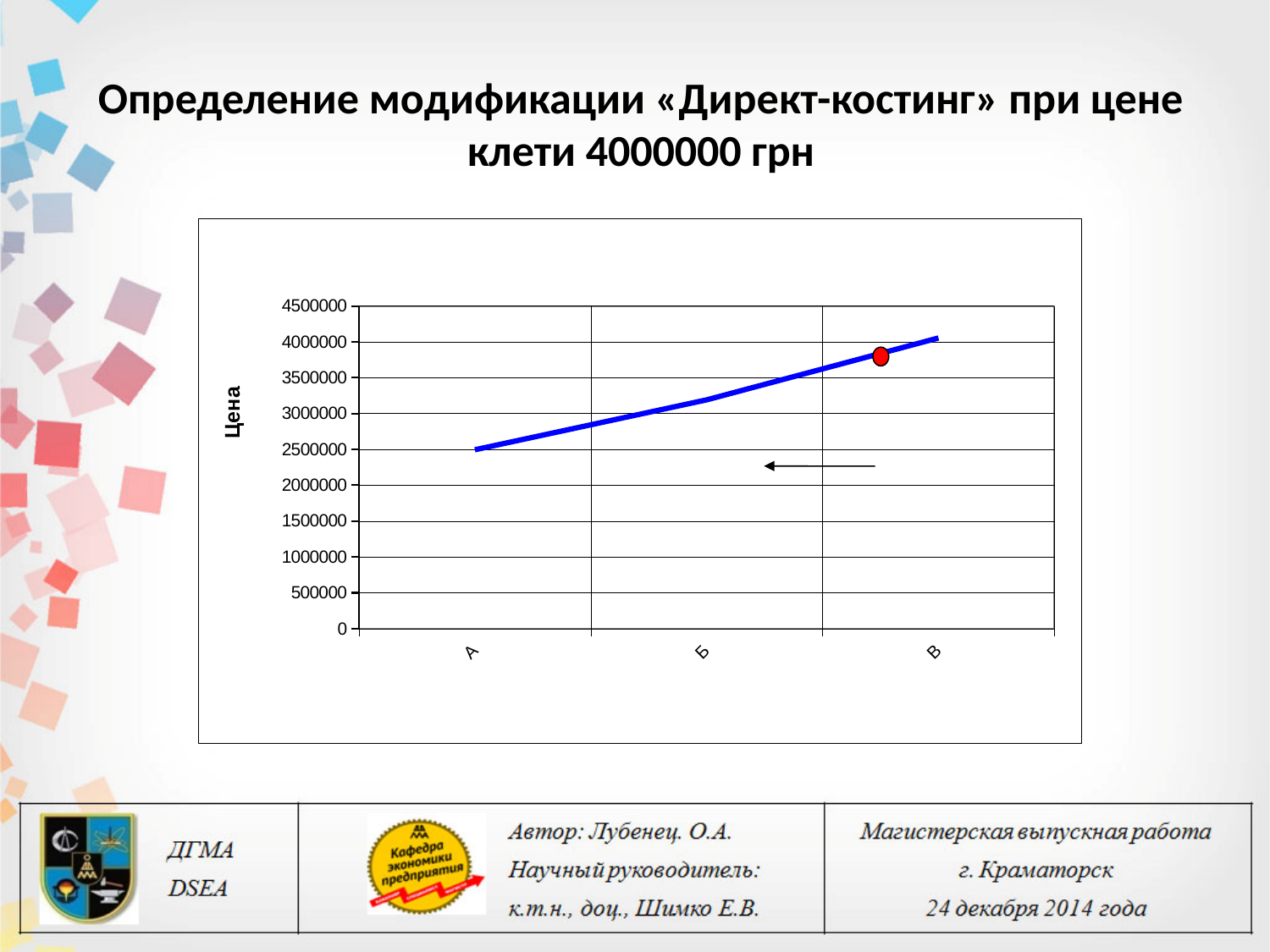
Is the value for В greater or less than 3500000? greater Do the values rise or fall along the x axis from А to В? rise What kind of chart is shown on the slide? line chart What is the label of the vertical axis of the chart? Цена Which is larger, the value for Б or the value for А? Б Which category has the highest value on the chart? В Is the value for Б greater or less than 3500000? less How many categories are shown on the x axis of the chart? 3 Which category has the lowest value on the chart? А Is the value for А greater or less than 3000000? less What is the highest tick value shown on the vertical axis? 4500000